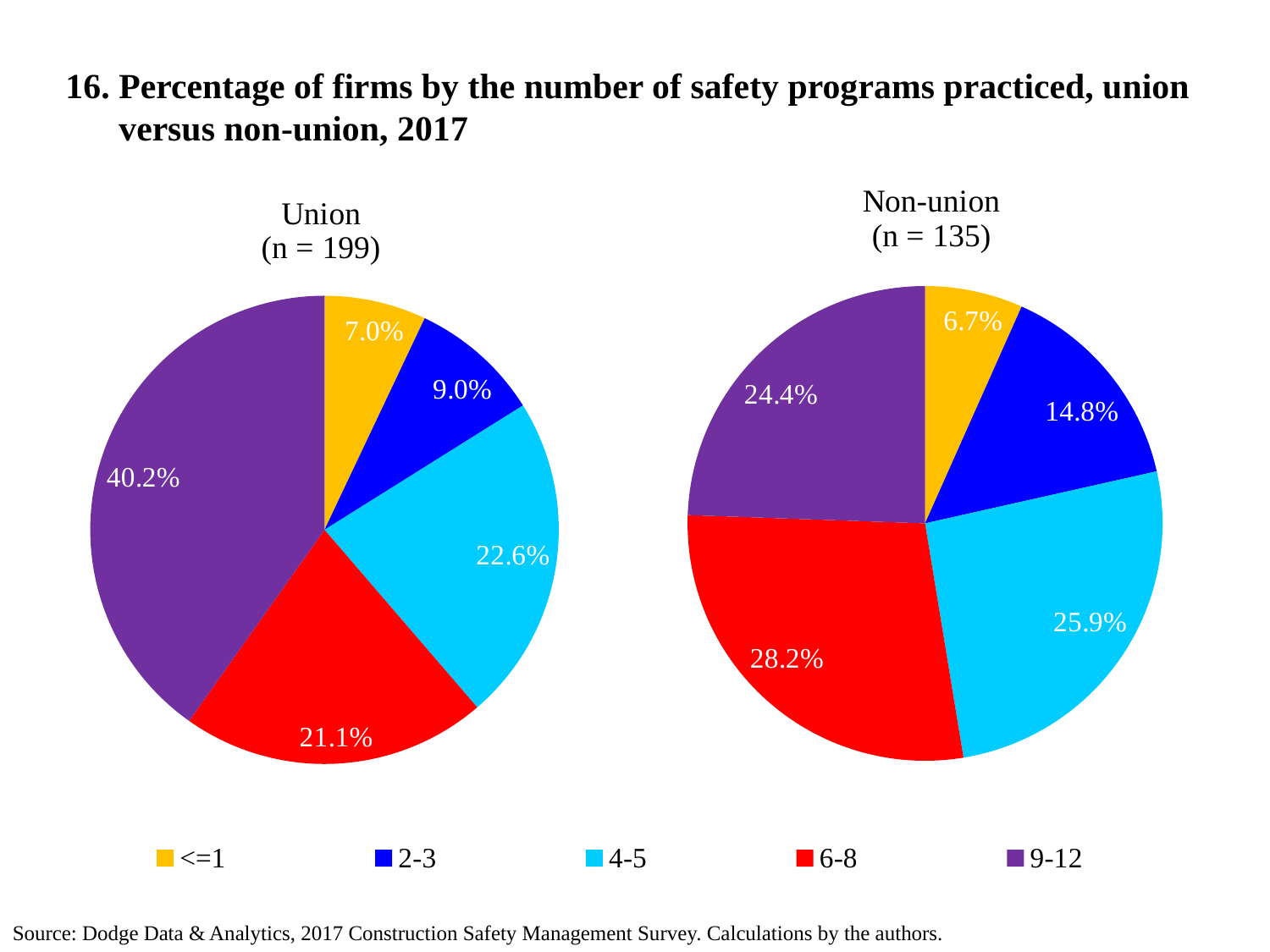
Which colour represents the 6-8 category in the legend? Red In the Union pie chart, what percentage of firms practice 9-12 safety programs? 40.2% In the Non-union pie chart, which category has the smallest share? <=1 What is the sample size (n) for the Union chart? 199 How many categories does the legend list? 5 In the Non-union pie chart, what percentage of firms practice 2-3 safety programs? 14.8% In the Non-union pie chart, which category has the largest share? 6-8 In the Union pie chart, which category has the largest share? 9-12 Which is larger: the 4-5 share in the Union chart or the 4-5 share in the Non-union chart? Non-union What type of chart is used on this slide? Pie chart What is the difference between the 9-12 share in the Union chart and the 9-12 share in the Non-union chart? 15.8% In the Non-union pie chart, what percentage of firms practice 6-8 safety programs? 28.2%